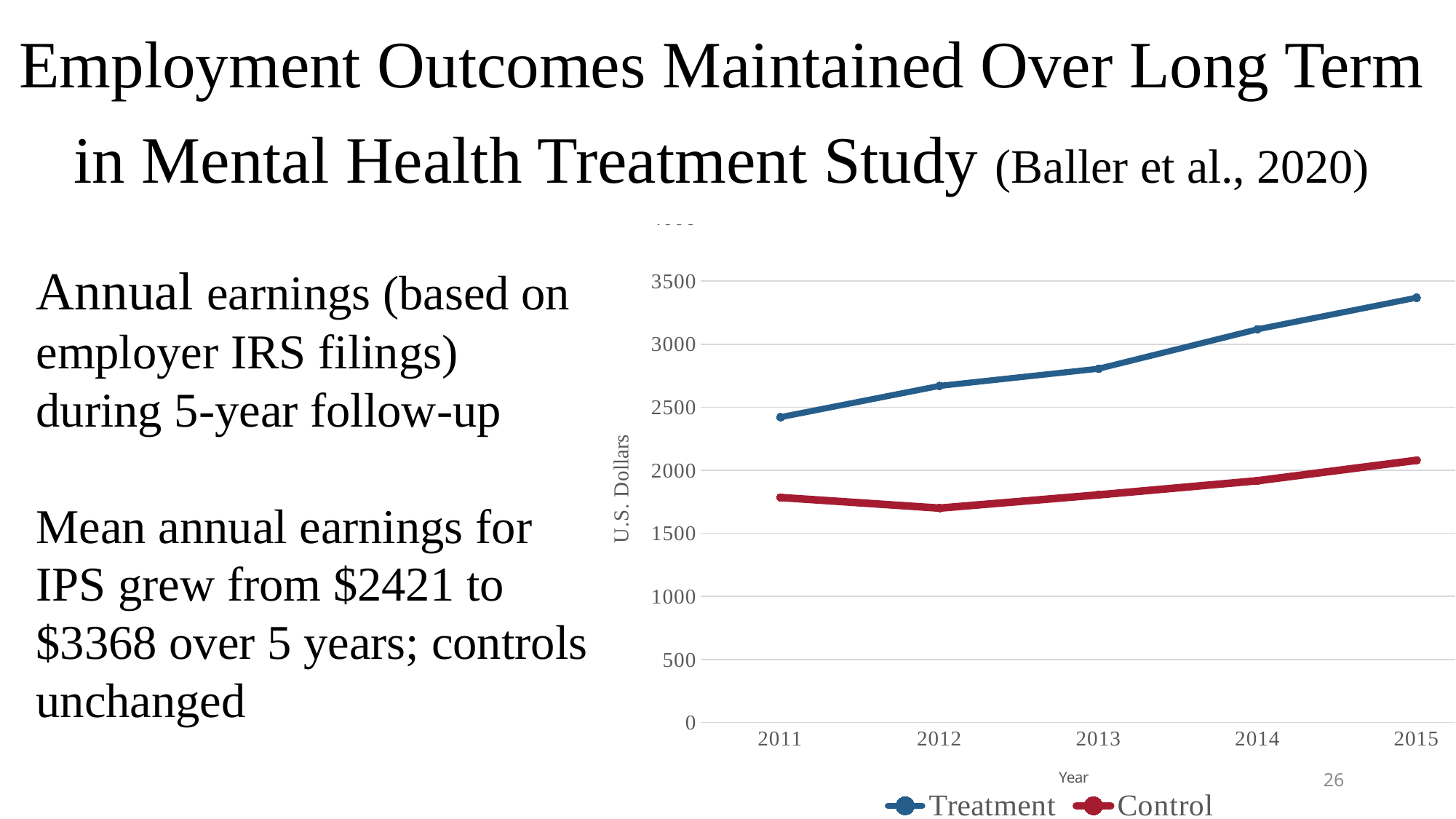
Which series has the higher value in 2015, Treatment or Control? Treatment In which year is the Control series at its lowest? 2012 How many series does the chart legend list? 2 In which year is the Treatment series at its highest? 2015 What is the label on the x axis of the chart? Year What kind of chart is shown on the slide? line chart How many years are plotted along the x axis of the chart? 5 Is the value for Treatment in 2015 greater or less than 3000? greater Is the value for Control in 2011 greater or less than 2000? less Does the Treatment series rise or fall from 2011 to 2015? rise Is the value for Treatment in 2011 greater or less than 2500? less What is the label on the y axis of the chart? U.S. Dollars